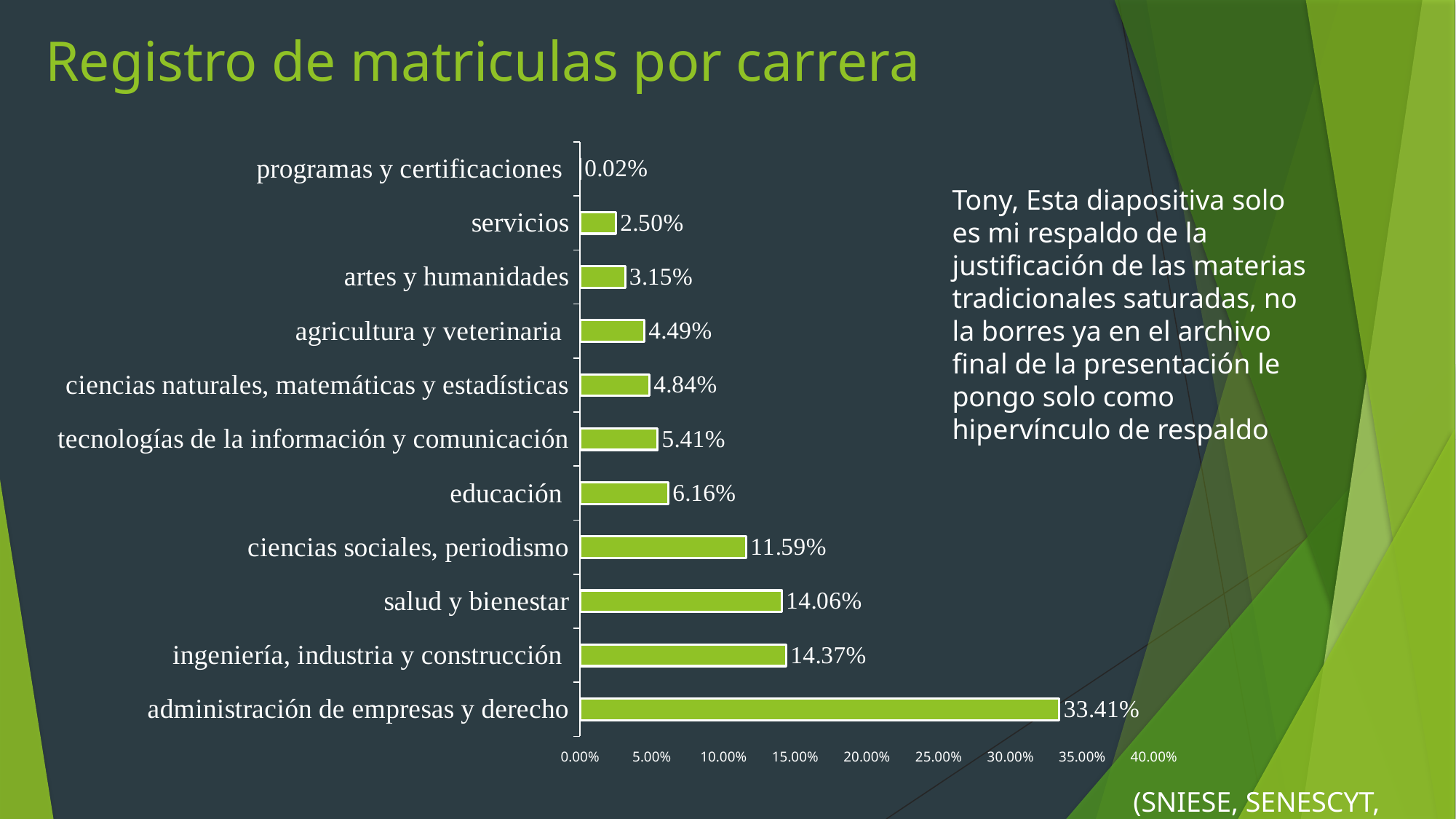
How many categories are shown in the chart? 11 What is the value for programas y certificaciones? 0.02% What is the value for educación? 6.16% What is the value for administración de empresas y derecho? 33.41% Which category has the highest value? administración de empresas y derecho What is the value for ciencias sociales, periodismo? 11.59% Which category has the lowest value? programas y certificaciones Which is larger, the value for servicios or the value for artes y humanidades? artes y humanidades What is the difference between the values for ingeniería, industria y construcción and salud y bienestar? 0.31% What is the title of the slide containing the chart? Registro de matriculas por carrera Is the value for administración de empresas y derecho greater or less than 30.00%? greater What kind of chart is shown on the slide? bar chart